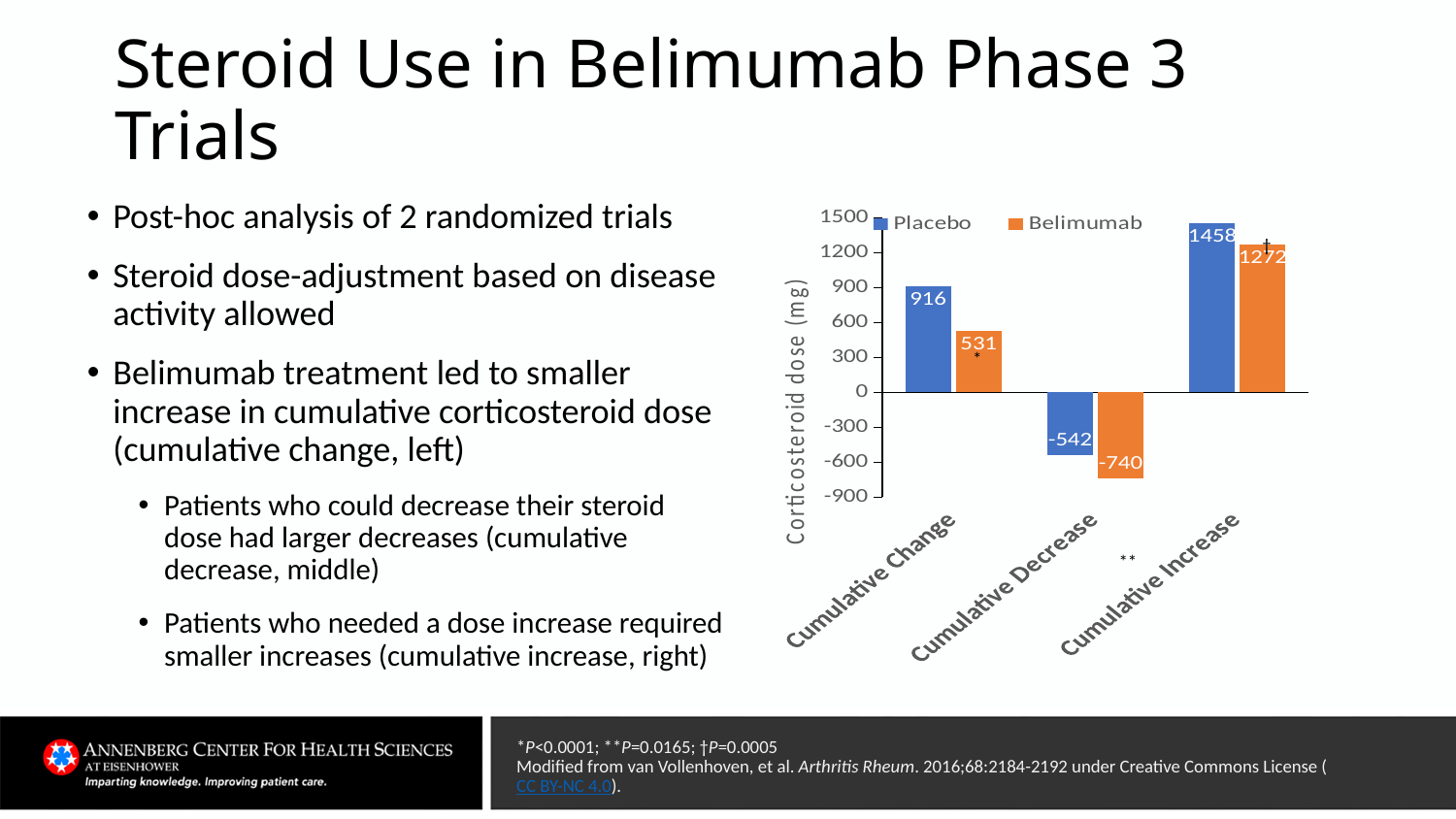
What is the Placebo value for Cumulative Change? 916 How many series does the legend list? 2 What kind of chart is shown on the slide? Bar chart What is the Placebo value for Cumulative Decrease? -542 What is the difference between the Placebo and Belimumab values for Cumulative Change? 385 What is the Belimumab value for Cumulative Increase? 1272 How many categories are shown on the x axis? 3 What is the Placebo value for Cumulative Increase? 1458 Which is larger for Cumulative Increase, the Placebo value or the Belimumab value? Placebo What is the Belimumab value for Cumulative Change? 531 Which category has the highest Placebo value? Cumulative Increase What is the Belimumab value for Cumulative Decrease? -740